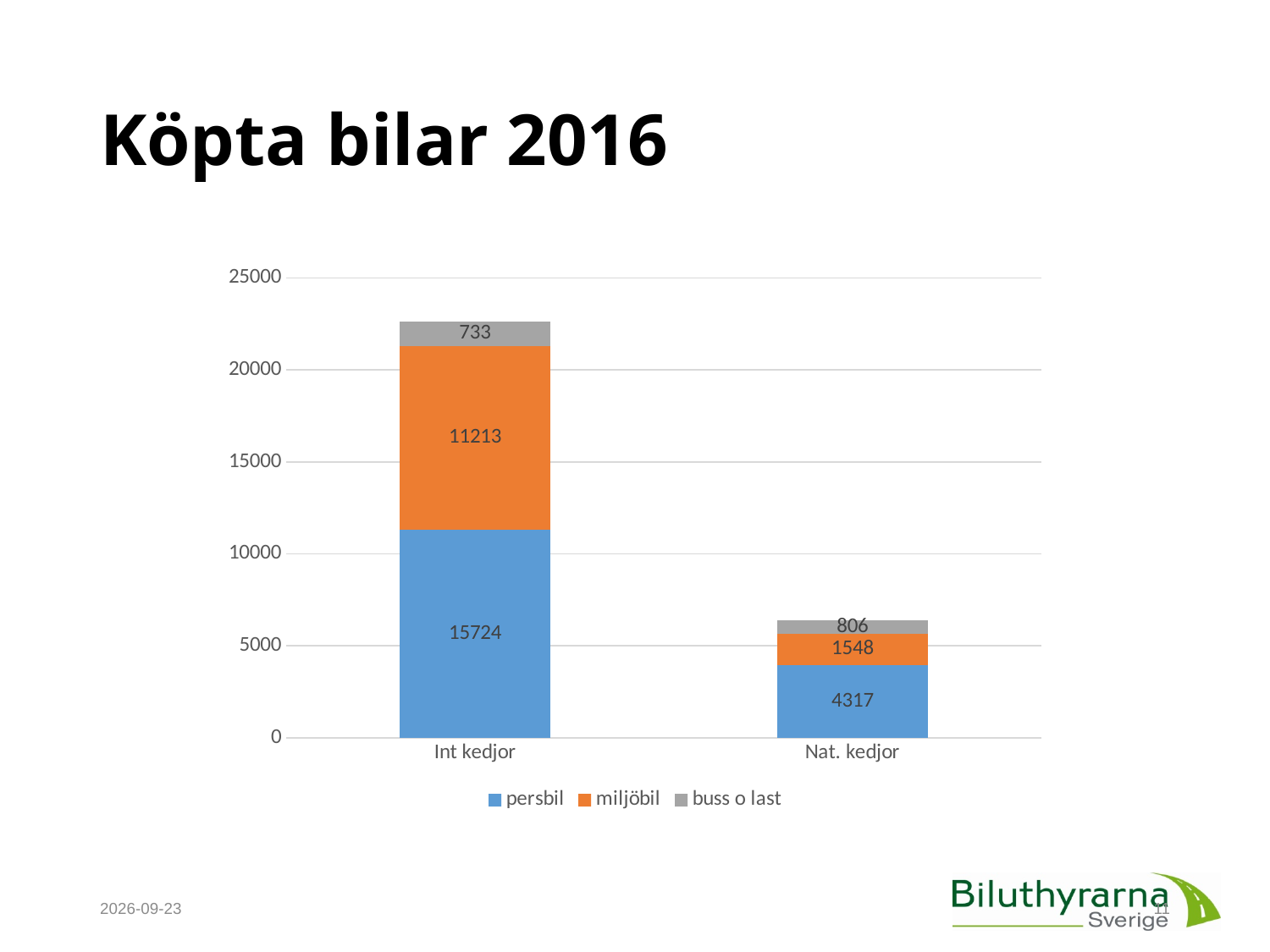
What is the miljöbil value for Nat. kedjor? 1548 What is the buss o last value for Int kedjor? 733 What kind of chart is shown on the slide? stacked bar chart What is the title of the slide? Köpta bilar 2016 What is the persbil value for Nat. kedjor? 4317 Which category has the higher persbil value, Int kedjor or Nat. kedjor? Int kedjor Is the total height of the Int kedjor bar greater or less than 20000? greater How many categories are shown on the x axis? 2 How many series does the legend list? 3 What is the difference between the persbil values for Int kedjor and Nat. kedjor? 11407 What is the persbil value for Int kedjor? 15724